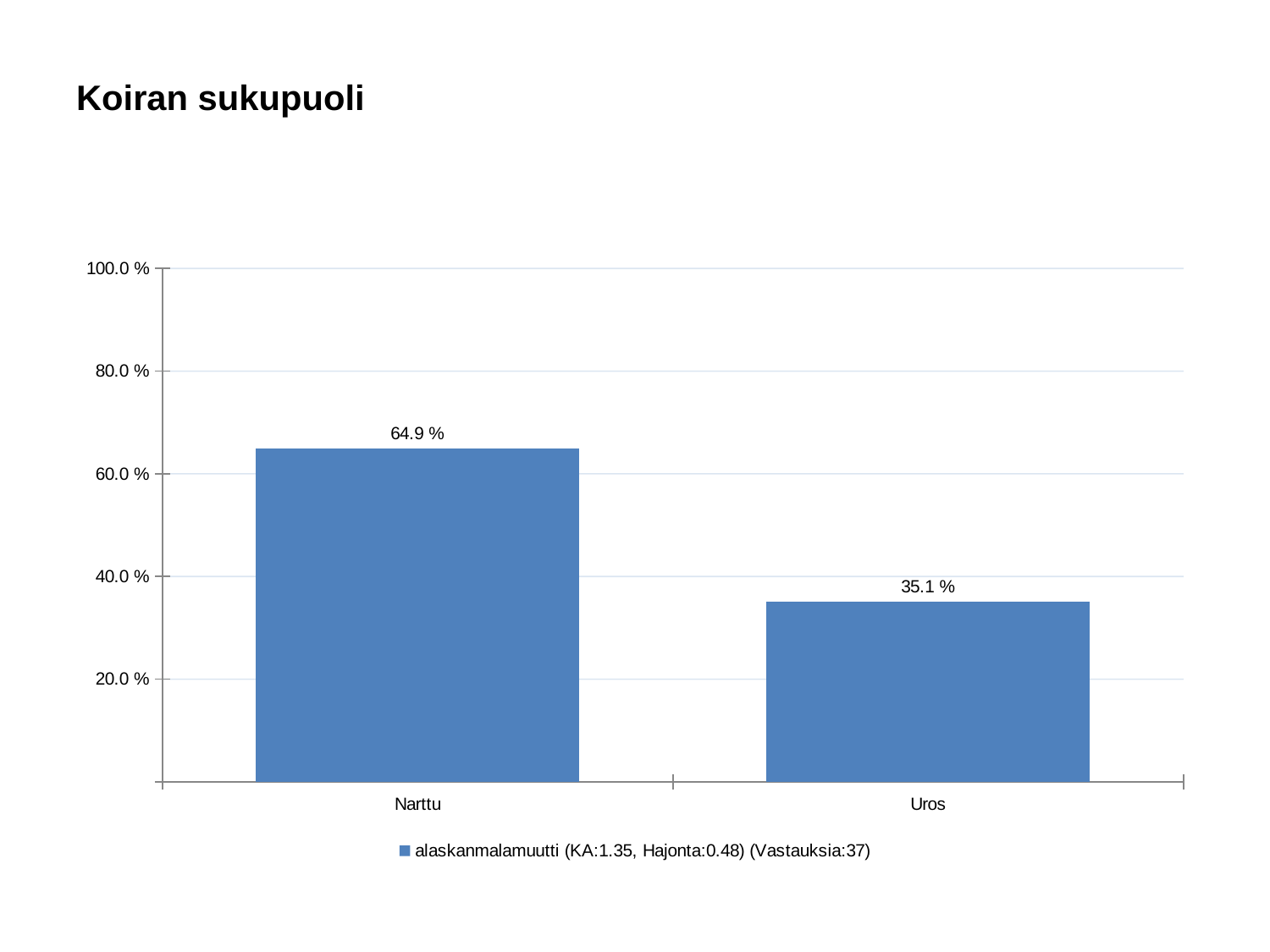
Is the value for Uros greater or less than 40.0 %? less What is the difference between the values for Narttu and Uros? 29.8 % What kind of chart is shown on the slide? bar chart Is the value for Narttu greater or less than 60.0 %? greater How many categories are shown on the x axis? 2 What is the value for Uros? 35.1 % Which category has the highest value? Narttu Which category has the lowest value? Uros What is the title of the slide? Koiran sukupuoli Which is larger, the value for Narttu or the value for Uros? Narttu How many series does the legend list? 1 What is the value for Narttu? 64.9 %